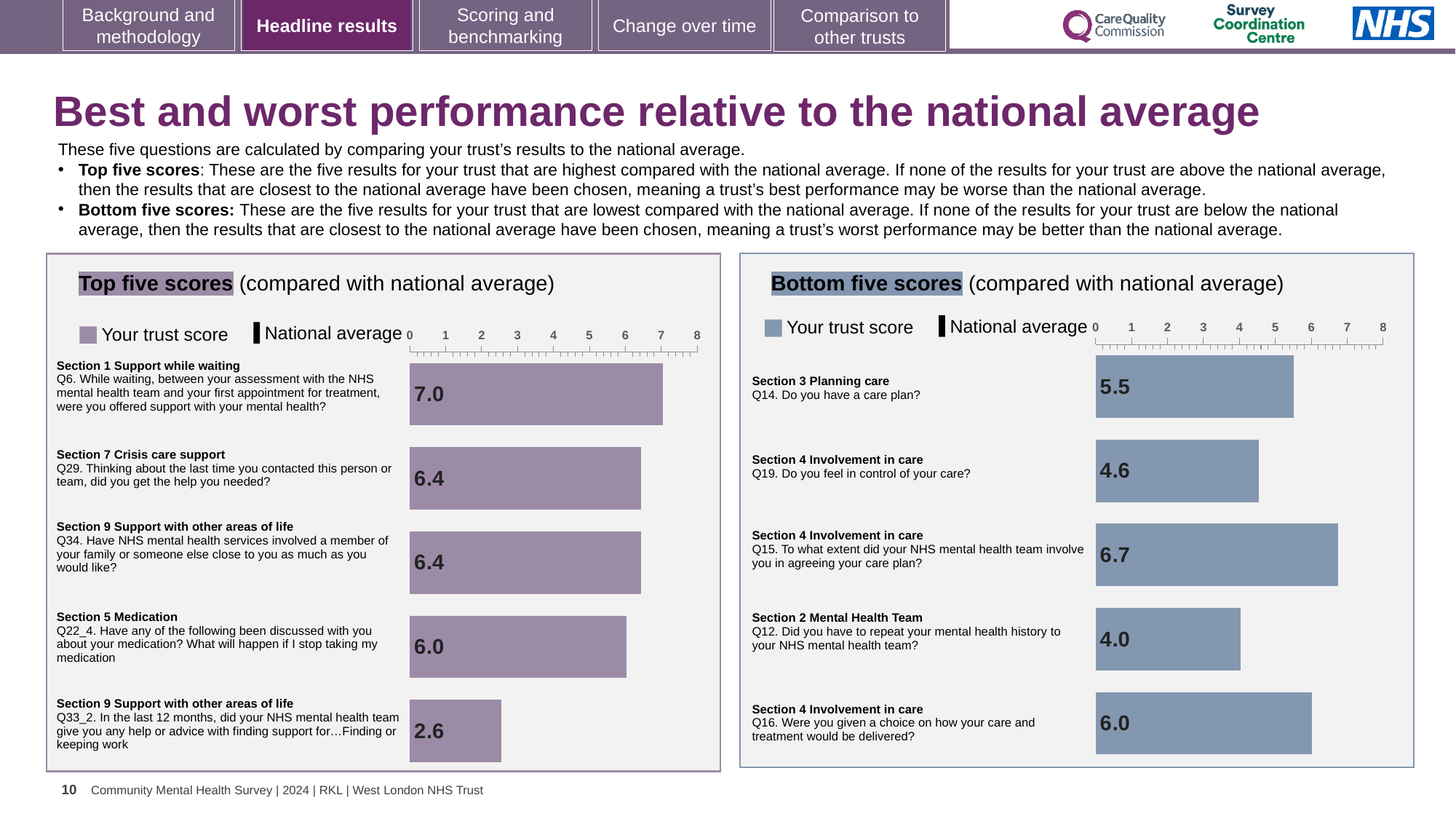
What type of chart is used in the Top five scores panel? Bar chart In the Bottom five scores chart, which question has the lowest trust score? Q12 In the Bottom five scores chart, what is the trust score for Q14 (do you have a care plan)? 5.5 In the Top five scores chart, how many questions are plotted? 5 How many entries does the legend of the Bottom five scores chart list? 2 In the Top five scores chart, what is the trust score for Q33_2 (help finding or keeping work)? 2.6 In the Bottom five scores chart, what is the difference between the trust scores for Q15 and Q12? 2.7 In the Top five scores chart, which question has the highest trust score? Q6 In the Bottom five scores chart, which has the larger trust score, Q19 or Q16? Q16 In the Top five scores chart, what is the difference between the trust scores for Q6 and Q22_4? 1.0 In the Bottom five scores chart, what is the trust score for Q15 (involved in agreeing your care plan)? 6.7 In the Top five scores chart, what is the trust score for Q6 (support while waiting)? 7.0